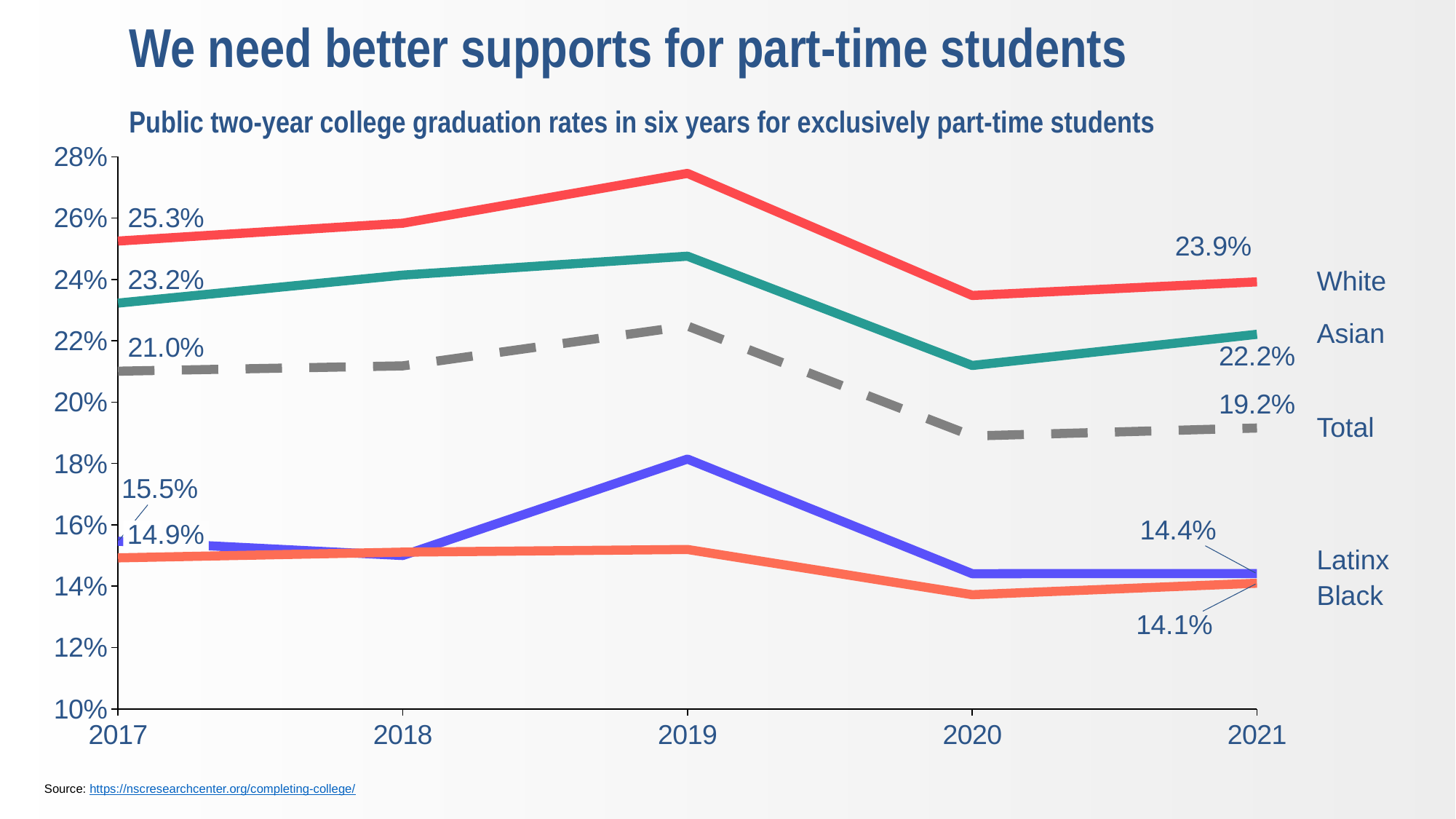
What kind of chart is shown on the slide? Line chart What was the graduation rate for White students in 2017? 25.3% Which group had the highest graduation rate in 2021? White What was the graduation rate for Asian students in 2021? 22.2% Which was higher in 2021, the Latinx rate or the Black rate? Latinx How many groups (series) are plotted on the chart? 5 What was the Total graduation rate in 2017? 21.0% By how many percentage points did the White graduation rate change from 2017 to 2021? 1.4 percentage points lower What was the graduation rate for Black students in 2021? 14.1% Which group had the lowest graduation rate in 2017? Black Is the White graduation rate in 2019 greater or less than 26%? greater How many years are shown on the x axis? 5